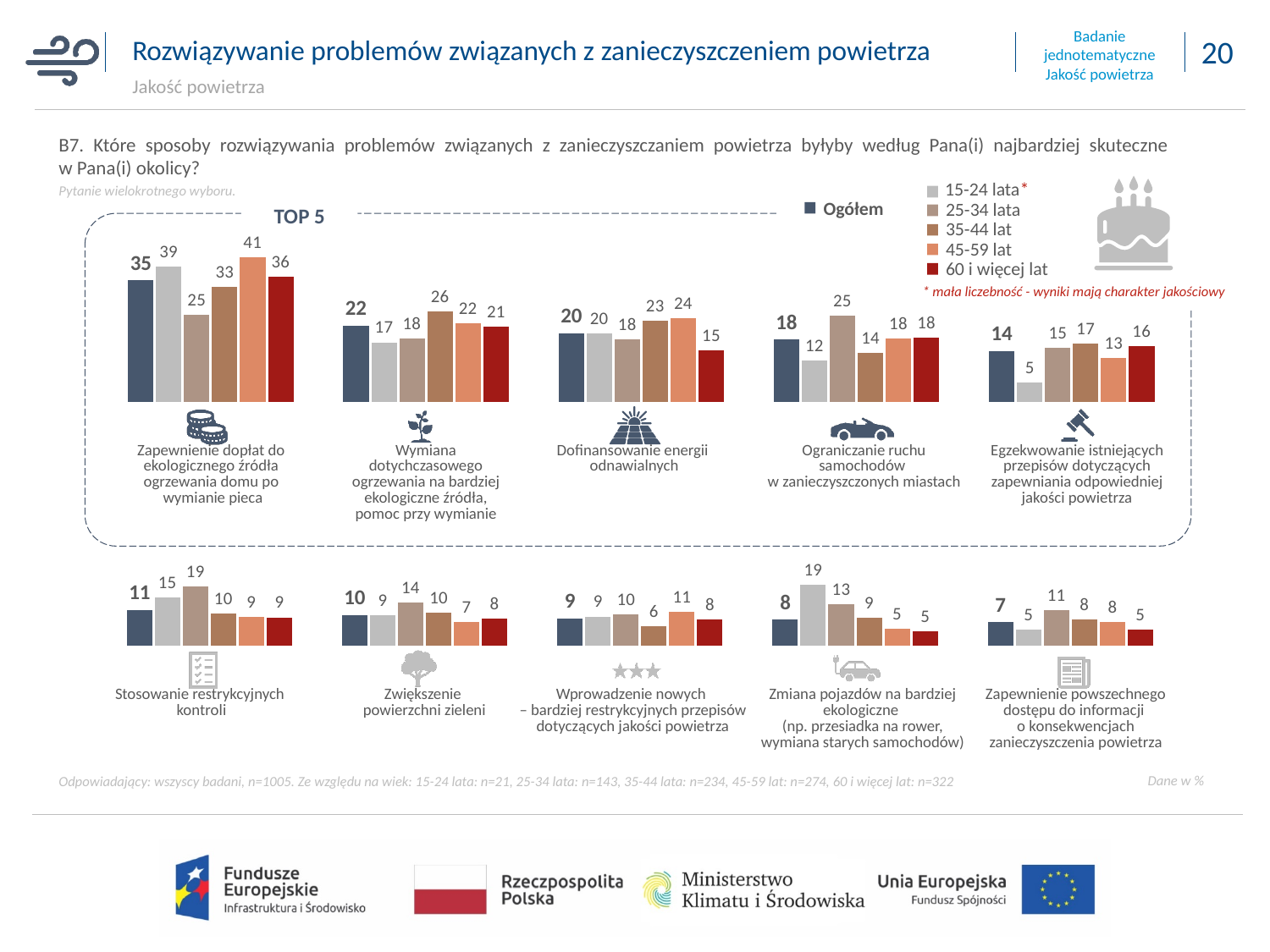
In the chart 'Dofinansowanie energii odnawialnych', which is larger: the value for 45-59 lat or the value for 60 i więcej lat? 45-59 lat In the chart 'Stosowanie restrykcyjnych kontroli', what is the difference between the 25-34 lata value and the Ogółem value? 8 In the chart 'Egzekwowanie istniejących przepisów dotyczących zapewniania odpowiedniej jakości powietrza', which age group has the lowest value? 15-24 lata In the chart 'Zmiana pojazdów na bardziej ekologiczne', what is the value for 15-24 lata? 19 How many series does the legend list? 6 How many charts are grouped inside the dashed 'TOP 5' box? 5 In the chart 'Zapewnienie powszechnego dostępu do informacji o konsekwencjach zanieczyszczenia powietrza', what is the value for Ogółem? 7 In the chart 'Ograniczanie ruchu samochodów w zanieczyszczonych miastach', what is the value for 25-34 lata? 25 In the chart 'Wymiana dotychczasowego ogrzewania na bardziej ekologiczne źródła, pomoc przy wymianie', what is the difference between the 35-44 lat value and the 15-24 lata value? 9 In the chart 'Zapewnienie dopłat do ekologicznego źródła ogrzewania domu po wymianie pieca', which age group has the highest value? 45-59 lat In the chart 'Zapewnienie dopłat do ekologicznego źródła ogrzewania domu po wymianie pieca', what is the value for Ogółem? 35 What kind of chart is used for 'Zwiększenie powierzchni zieleni'? bar chart